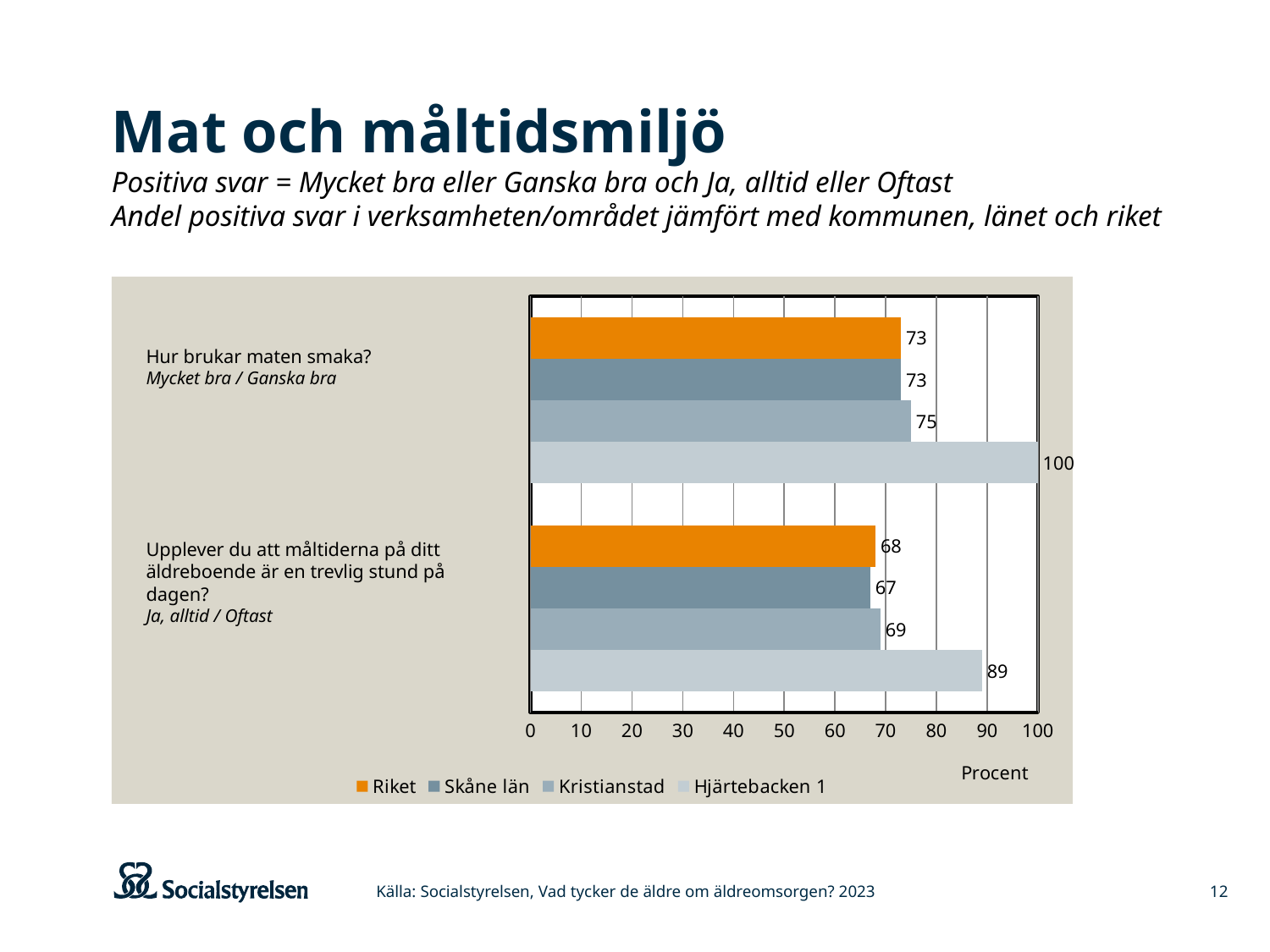
What is the difference between Hjärtebacken 1 and Kristianstad on the question 'Upplever du att måltiderna på ditt äldreboende är en trevlig stund på dagen?' 20 What kind of chart is shown on the slide? bar chart Is the value for Hjärtebacken 1 on 'Hur brukar maten smaka?' larger or smaller than its value on 'Upplever du att måltiderna på ditt äldreboende är en trevlig stund på dagen?' larger Which series has the highest value on the question 'Upplever du att måltiderna på ditt äldreboende är en trevlig stund på dagen?' Hjärtebacken 1 Which series has the lowest value on the question 'Upplever du att måltiderna på ditt äldreboende är en trevlig stund på dagen?' Skåne län What is the value for Riket on the question 'Upplever du att måltiderna på ditt äldreboende är en trevlig stund på dagen?' 68 What is the value for Kristianstad on the question 'Upplever du att måltiderna på ditt äldreboende är en trevlig stund på dagen?' 69 What is the label of the x axis? Procent What is the value for Hjärtebacken 1 on the question 'Hur brukar maten smaka?' 100 What is the difference between Hjärtebacken 1 and Riket on the question 'Hur brukar maten smaka?' 27 What is the value for Skåne län on the question 'Hur brukar maten smaka?' 73 How many series does the legend list? 4